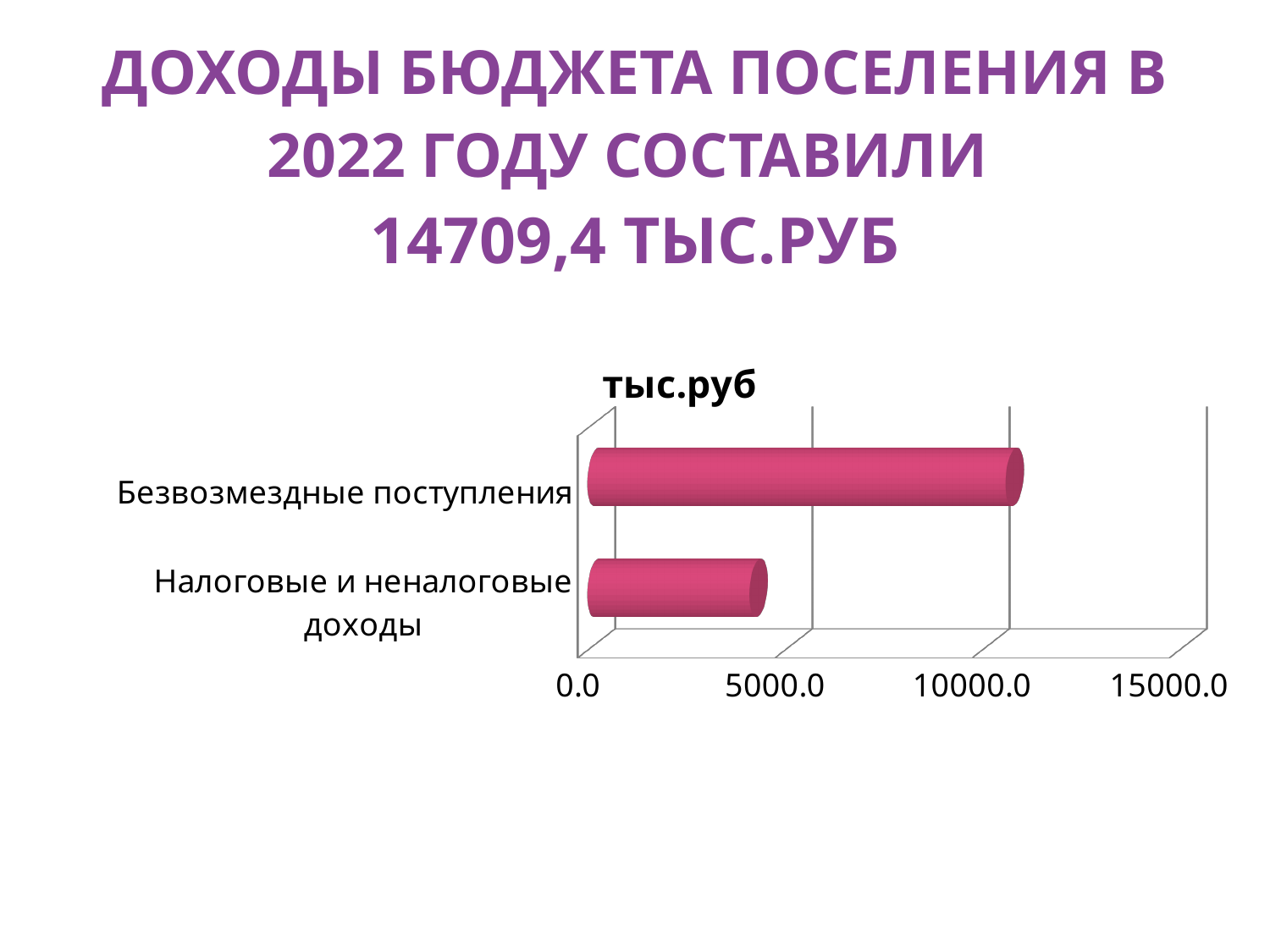
Which category has the lowest value in the chart? Налоговые и неналоговые доходы Is the value for Безвозмездные поступления greater or less than 15000.0? less Which category has the highest value in the chart? Безвозмездные поступления How many categories are plotted in the chart? 2 What is the title of the chart? тыс.руб Which is larger: the value for Безвозмездные поступления or the value for Налоговые и неналоговые доходы? Безвозмездные поступления What kind of chart is shown on the slide? bar chart What is the highest value shown on the chart's horizontal axis? 15000.0 Is the value for Налоговые и неналоговые доходы greater or less than 10000.0? less Is the value for Безвозмездные поступления greater or less than 5000.0? greater